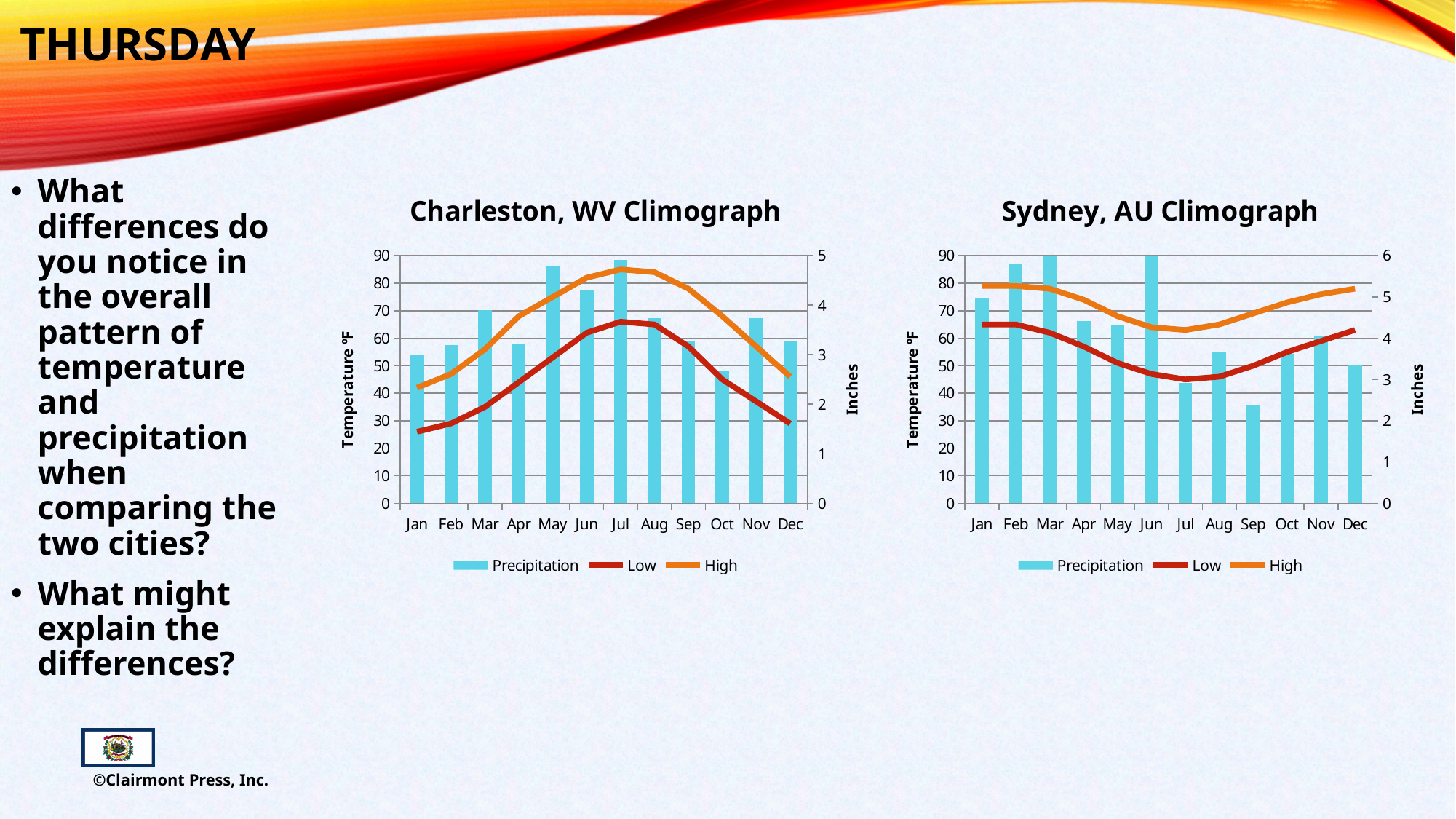
In the Charleston, WV Climograph, what kind of chart is used to show precipitation? bar chart In the Sydney, AU Climograph, is the precipitation for Sep greater or less than 3 inches? less Which is larger: the Jul Low temperature in the Charleston, WV Climograph or the Jul Low temperature in the Sydney, AU Climograph? Charleston, WV In the Charleston, WV Climograph, is the Low temperature for Jan greater or less than 30 °F? less In the Sydney, AU Climograph, how many series does the legend list? 3 In the Sydney, AU Climograph, does the High temperature line rise or fall from Jan to Jul? fall In the Sydney, AU Climograph, which month has the lowest precipitation? Sep In the Charleston, WV Climograph, does the High temperature line rise or fall from Jan to Jul? rise In the Charleston, WV Climograph, how many months are shown on the x axis? 12 In the Charleston, WV Climograph, which month has the lowest precipitation? Oct In the Charleston, WV Climograph, is the precipitation for Jul greater or less than 4 inches? greater In the Sydney, AU Climograph, what are the three legend entries? Precipitation, Low, High